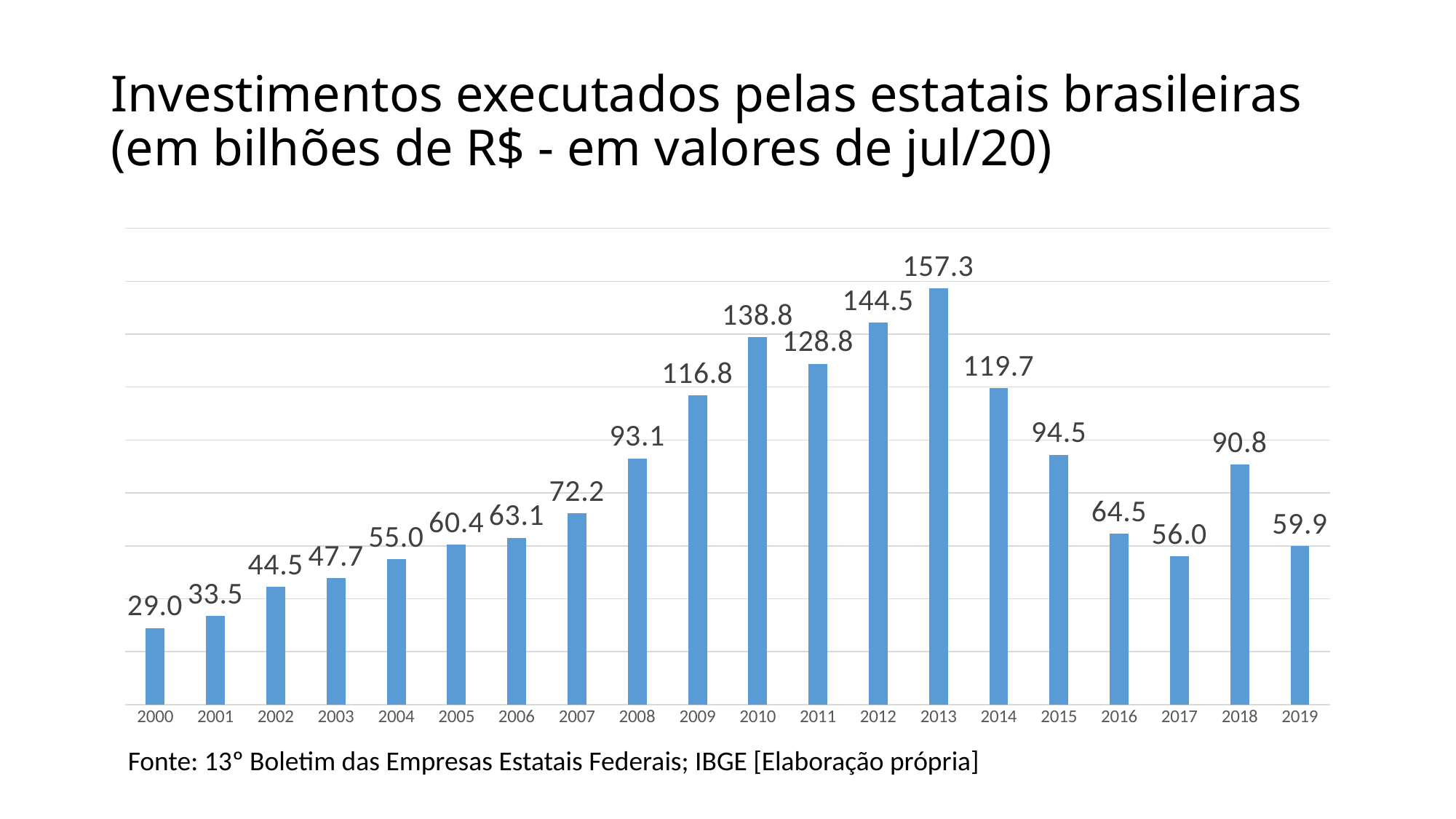
Which is larger, the value for 2016 or the value for 2017? 2016 What is the difference between the values for 2019 and 2000? 30.9 What is the difference between the values for 2013 and 2014? 37.6 Which year has the highest value? 2013 What kind of chart is this? Bar chart Which year has the lowest value? 2000 Do the values rise or fall from 2000 to 2013? Rise What is the value for 2000? 29.0 What is the value for 2013? 157.3 Which is larger, the value for 2012 or the value for 2010? 2012 What is the value for 2018? 90.8 How many years are shown on the x axis? 20